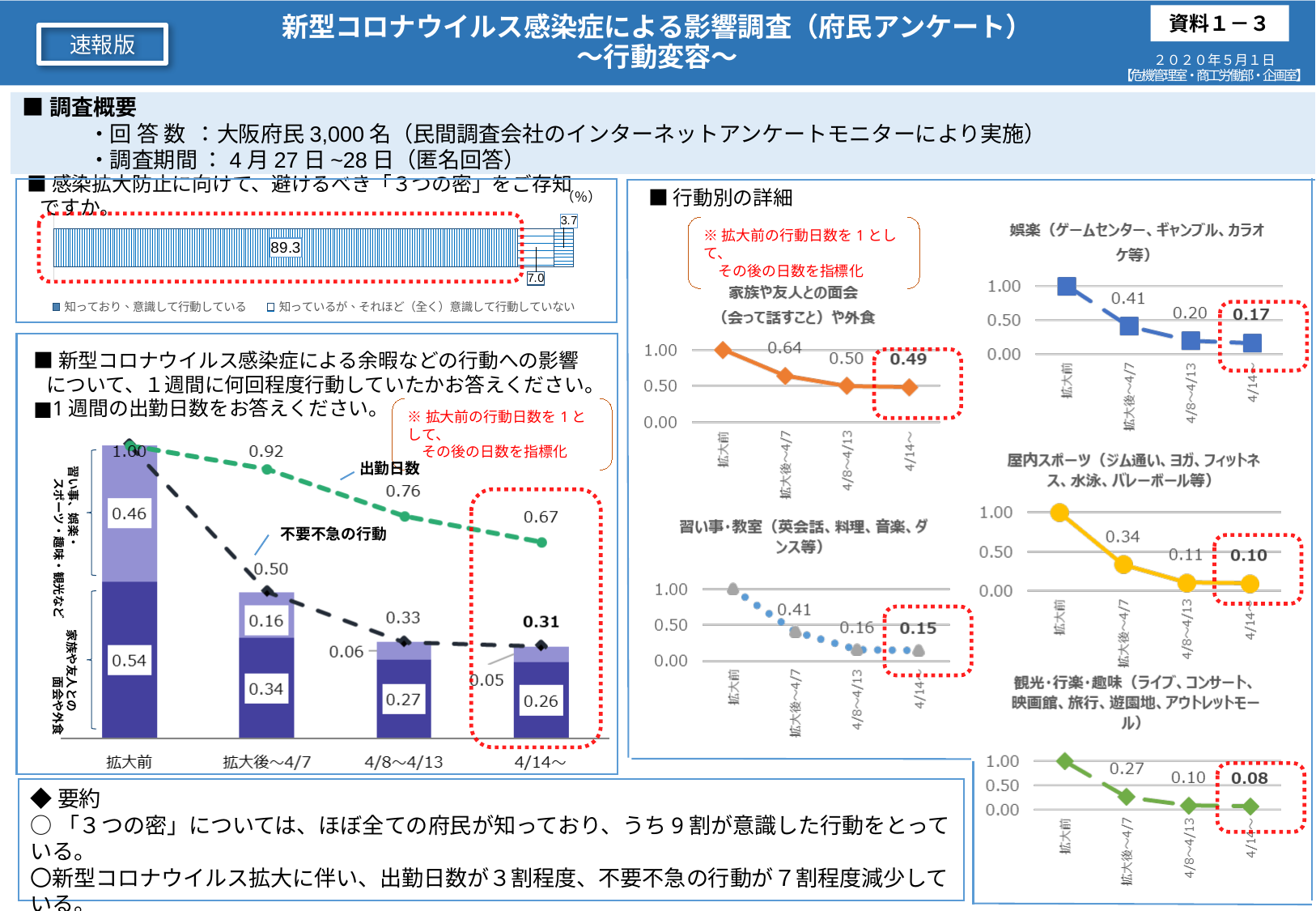
「3つの密」をご存知ですかの横棒グラフの凡例には、いくつの系列が示されていますか。 2 左下の「余暇などの行動への影響」のグラフで、「4/8〜4/13」の「出勤日数」と「不要不急の行動」の差はいくつですか。 0.43 「3つの密」をご存知ですかの横棒グラフで、「知っており、意識して行動している」の値は何%ですか。 89.3 左下の「余暇などの行動への影響」のグラフで、「出勤日数」の「4/14〜」の値はいくつですか。 0.67 「家族や友人との面会（会って話すこと）や外食」のグラフで、「4/14〜」の値はいくつですか。 0.49 左下の「余暇などの行動への影響」のグラフで、「4/14〜」の「家族や友人との面会や外食」の値はいくつですか。 0.26 左下の「余暇などの行動への影響」のグラフの横軸には、いくつの期間（カテゴリ）がありますか。 4 左下の「余暇などの行動への影響」のグラフで、「不要不急の行動」の値は「拡大前」から「4/14〜」にかけて上昇していますか、下降していますか。 下降 「習い事・教室（英会話、料理、音楽、ダンス等）」のグラフは、どの種類のグラフですか。 折れ線グラフ 「屋内スポーツ」のグラフと「観光・行楽・趣味」のグラフで、「4/14〜」の値が大きいのはどちらですか。 屋内スポーツ 「娯楽（ゲームセンター、ギャンブル、カラオケ等）」のグラフで、「拡大後〜4/7」の値はいくつですか。 0.41 左下の「余暇などの行動への影響」のグラフで、「拡大後〜4/7」の積み上げ棒の合計はいくつですか。 0.50